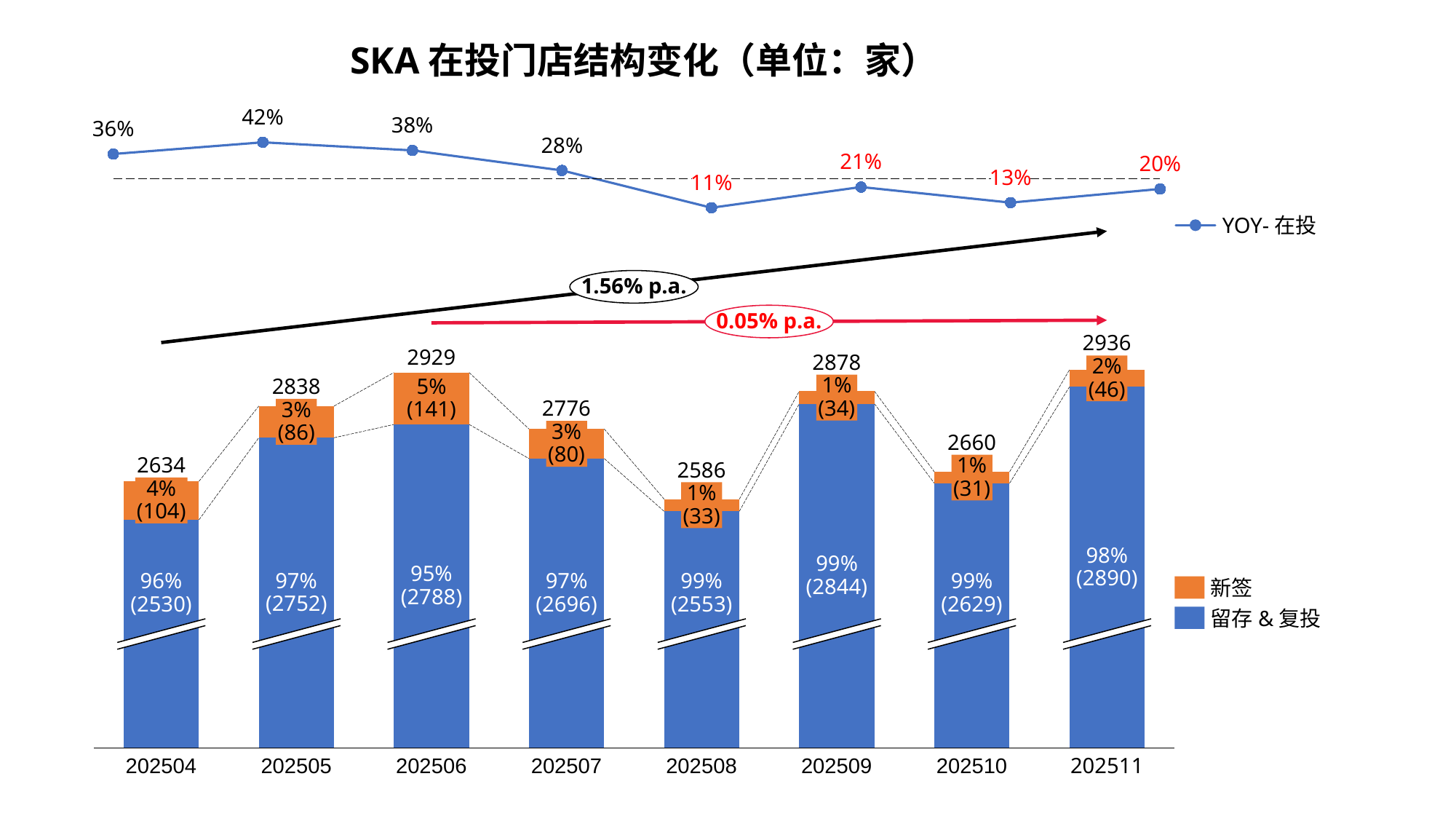
How many series does the legend list? 3 What is the 留存 & 复投 value (in parentheses) for 202509? 2844 How many months are shown on the x axis? 8 Which month has the highest total shown above its bar? 202511 What is the total number of stores shown above the bar for 202506? 2929 What is the difference between the totals for 202511 and 202510? 276 Which month has the lowest YOY- 在投 value? 202508 What is the title of the chart? SKA 在投门店结构变化（单位：家） Which is larger, the 新签 value for 202506 or for 202507? 202506 What kind of chart is used for the 新签 and 留存 & 复投 series? Stacked bar chart What is the 新签 value (in parentheses) for 202504? 104 What is the YOY- 在投 value for 202505? 42%